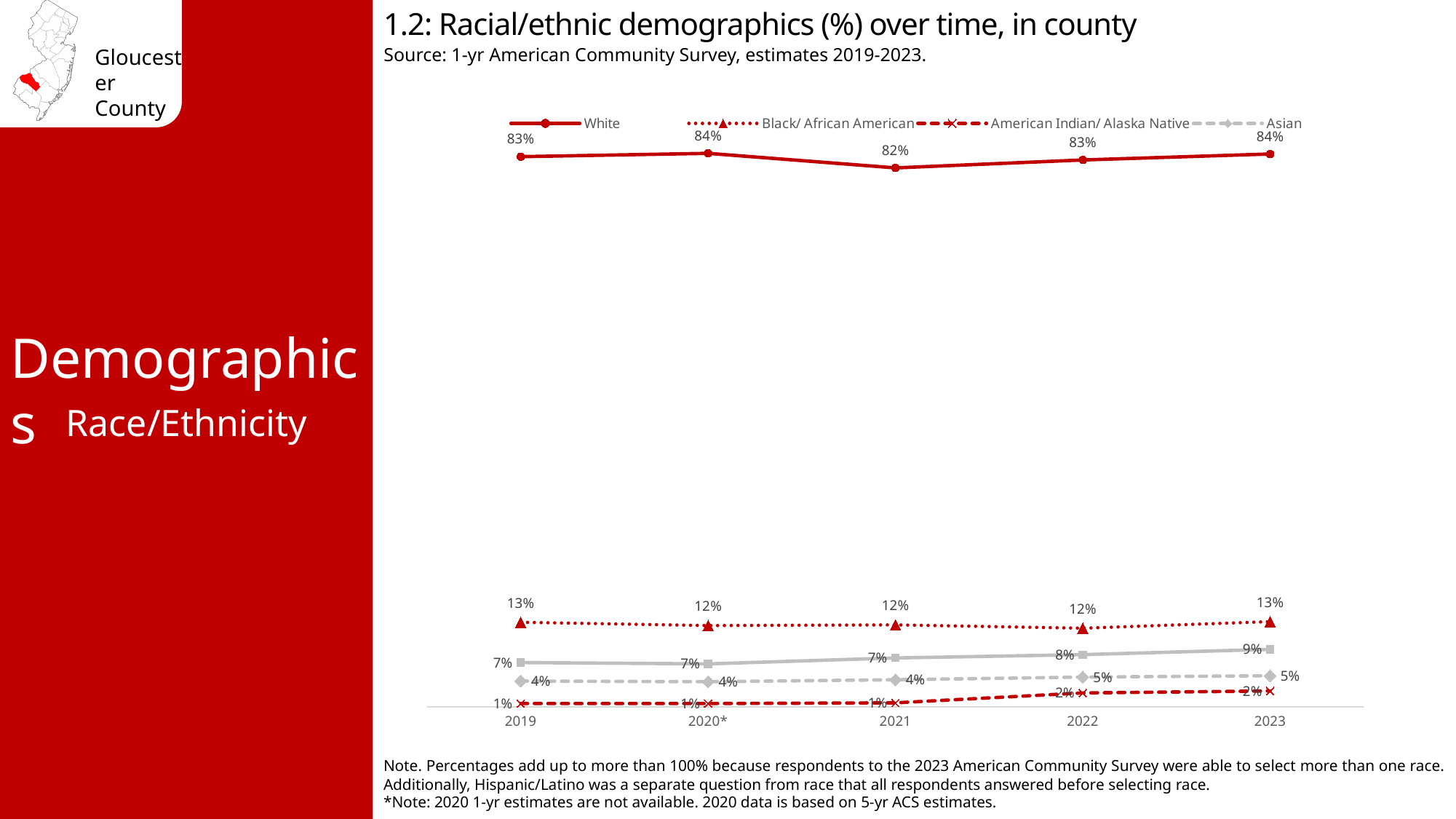
What is the value for White in 2021? 82% In which year is the White series at its lowest value? 2021 How many years are shown on the x axis? 5 What is the difference between the White value in 2023 and the White value in 2021? 2% What is the value for Asian in 2023? 5% What is the value for Black/ African American in 2019? 13% What type of chart is shown on the slide? line chart What is the title of the chart? 1.2: Racial/ethnic demographics (%) over time, in county What is the value for American Indian/ Alaska Native in 2022? 2% Does the Asian series rise or fall from 2019 to 2023? rise What is the difference between the Black/ African American value and the Asian value in 2019? 9% Which is larger in 2023: the Black/ African American value or the Asian value? Black/ African American